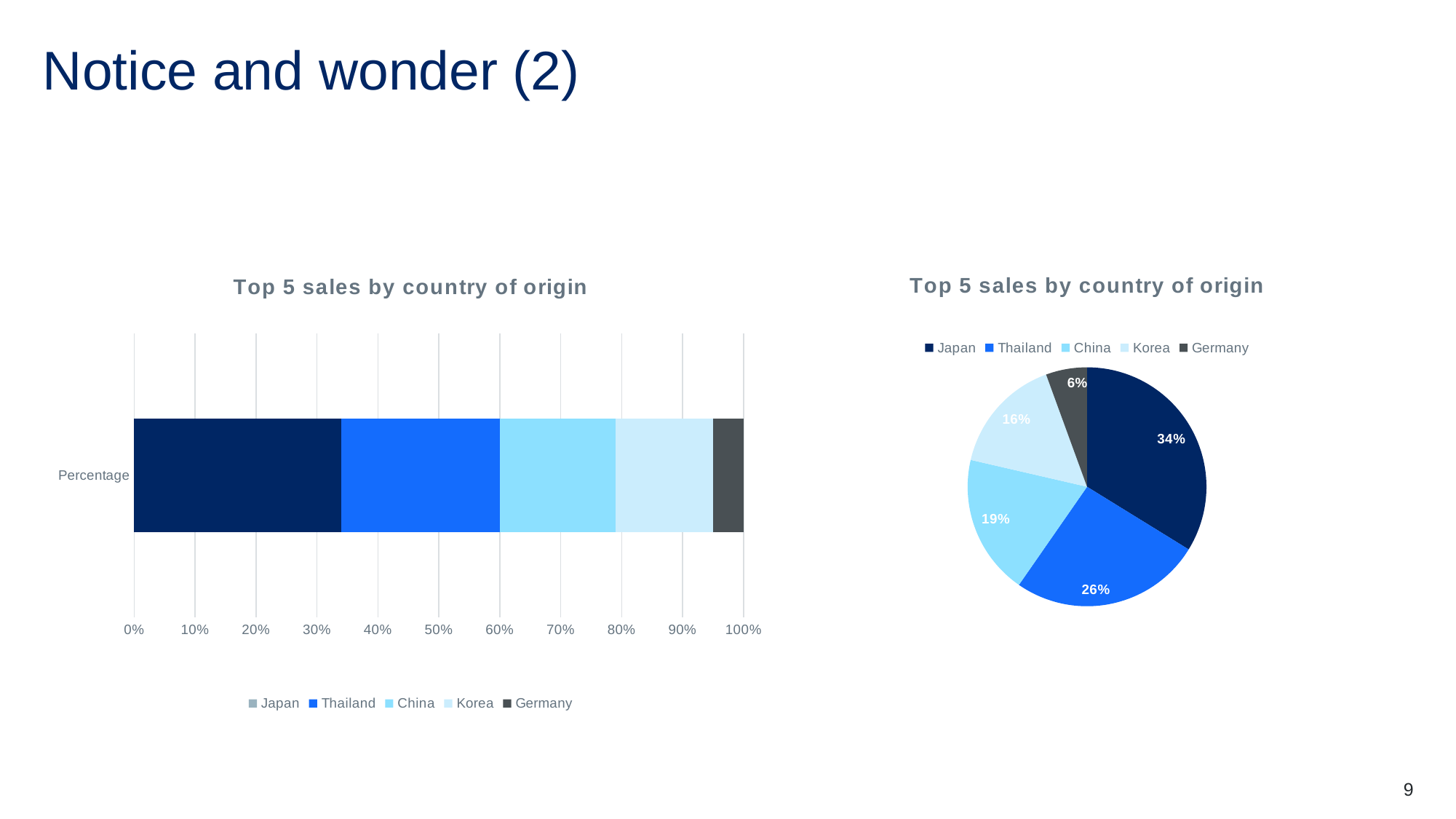
In the bar chart on the left, is the Japan segment of the Percentage bar greater or less than 30%? greater In the pie chart on the right, what share of the pie does Korea take? 16% In the pie chart on the right, which country has the smallest slice? Germany What is the title of the chart on the left of the slide? Top 5 sales by country of origin In the pie chart on the right, which is larger, the slice for China or the slice for Korea? China In the pie chart on the right, what percentage is shown for Thailand? 26% How many countries does the legend of the pie chart on the right list? 5 In the pie chart on the right, which country has the largest slice? Japan What kind of chart is the chart on the left of the slide? Bar chart In the pie chart on the right, what percentage is shown for Germany? 6% In the pie chart on the right, what is the difference between the percentages for Japan and Thailand? 8% In the pie chart on the right, what percentage is shown for Japan? 34%